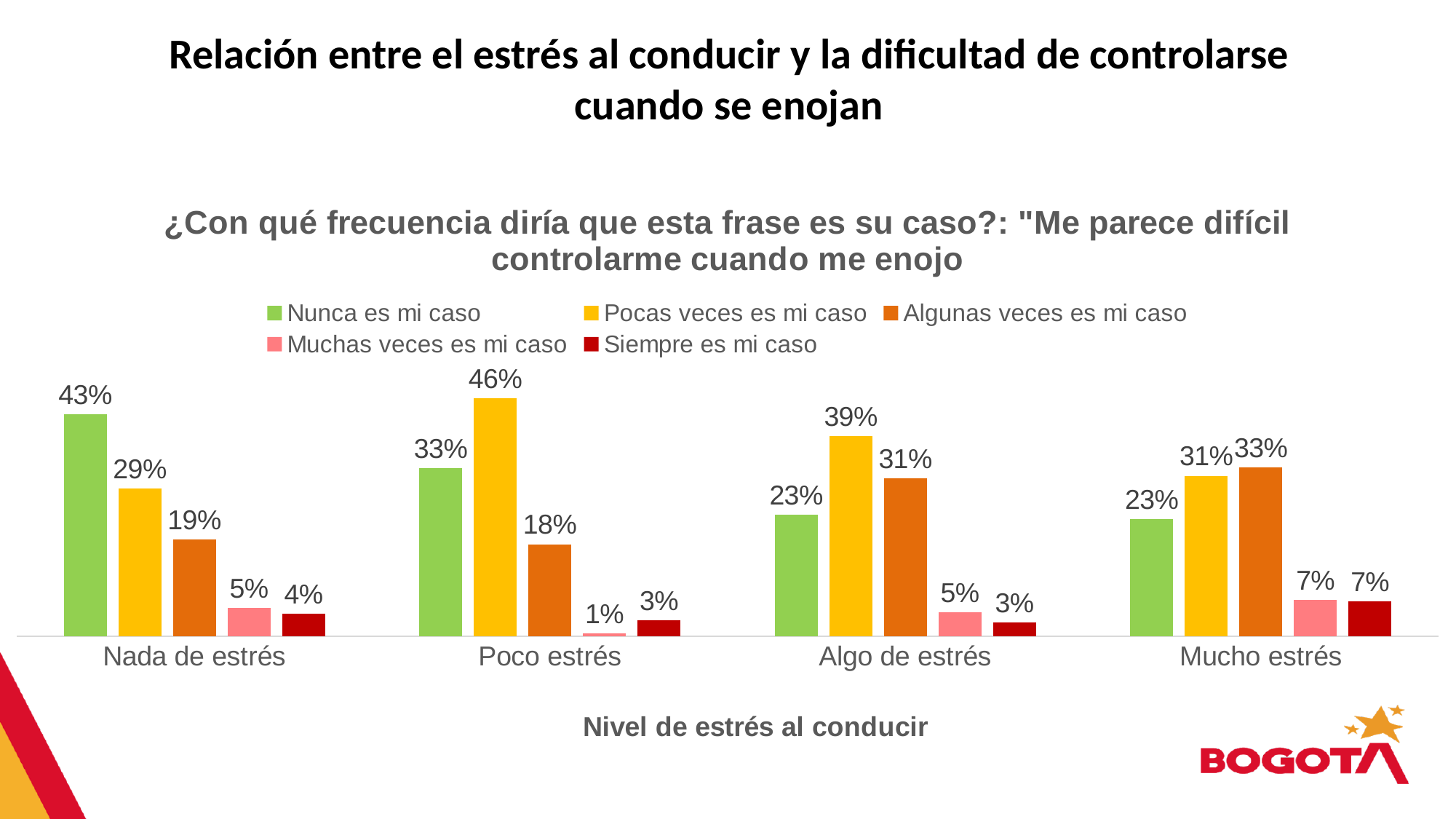
Which category has the lowest value for "Algunas veces es mi caso"? Poco estrés How many stress-level categories are shown on the x axis? 4 Which category has the highest value for "Nunca es mi caso"? Nada de estrés What kind of chart is shown on the slide? Bar chart What is the x-axis title of the chart? Nivel de estrés al conducir How many series does the legend list? 5 What is the value for "Muchas veces es mi caso" in the "Poco estrés" category? 1% In the "Nada de estrés" category, which is larger: "Nunca es mi caso" or "Pocas veces es mi caso"? Nunca es mi caso What is the difference between "Pocas veces es mi caso" and "Nunca es mi caso" in the "Algo de estrés" category? 16% What is the value for "Pocas veces es mi caso" in the "Poco estrés" category? 46% What is the value for "Algunas veces es mi caso" in the "Mucho estrés" category? 33% What is the value for "Nunca es mi caso" in the "Nada de estrés" category? 43%